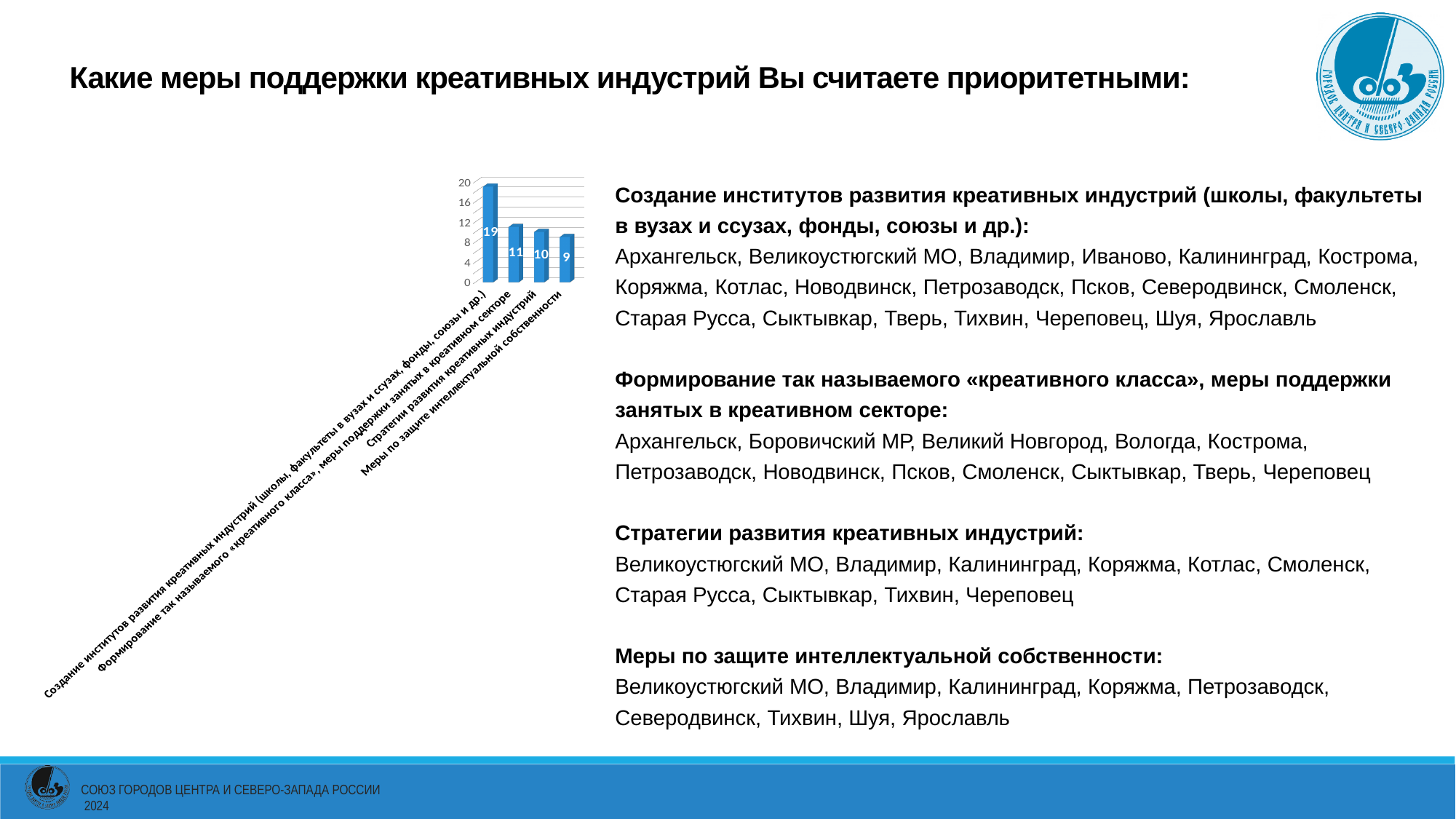
Which category has the highest value? Создание институтов развития креативных индустрий What kind of chart is shown on the slide? Bar chart Which category has the lowest value? Меры по защите интеллектуальной собственности What value is shown for «Стратегии развития креативных индустрий»? 10 What value is shown for «Создание институтов развития креативных индустрий»? 19 What value is shown for «Формирование так называемого «креативного класса»»? 11 Which is larger: the value for «Формирование так называемого «креативного класса»» or for «Стратегии развития креативных индустрий»? Формирование так называемого «креативного класса» How many categories are shown in the chart? 4 Do the values rise or fall from left to right along the x axis? Fall What value is shown for «Меры по защите интеллектуальной собственности»? 9 What is the difference between the values for «Создание институтов развития креативных индустрий» and «Меры по защите интеллектуальной собственности»? 10 Is the value for «Создание институтов развития креативных индустрий» greater or less than 16? greater